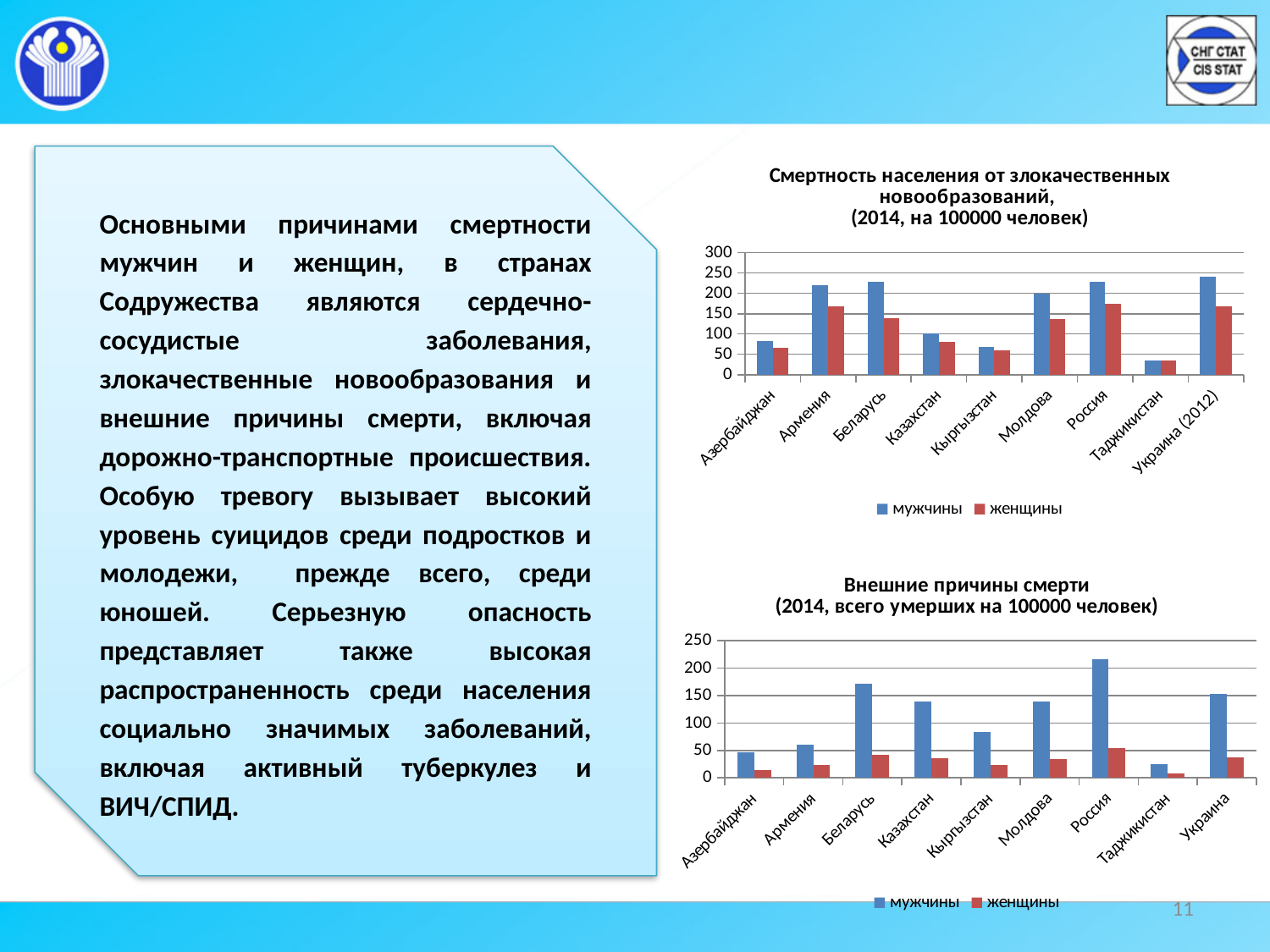
In the top chart (Смертность населения от злокачественных новообразований), is the value for женщины in Казахстан greater or less than 100? less What type of chart is the bottom chart (Внешние причины смерти)? bar chart In the top chart (Смертность населения от злокачественных новообразований), which country has the highest value for мужчины? Украина (2012) In the bottom chart (Внешние причины смерти), which country has the highest value for мужчины? Россия In the top chart (Смертность населения от злокачественных новообразований), which country has the lowest value for мужчины? Таджикистан How many countries are shown on the x axis of the top chart (Смертность населения от злокачественных новообразований)? 9 In the bottom chart (Внешние причины смерти), is the value for мужчины in Россия greater or less than 200? greater In the top chart (Смертность населения от злокачественных новообразований), which is larger for Беларусь: мужчины or женщины? мужчины How many series does the legend of the bottom chart (Внешние причины смерти) list? 2 In the bottom chart (Внешние причины смерти), which country has the lowest value for женщины? Таджикистан In the bottom chart (Внешние причины смерти), is the value for мужчины in Азербайджан greater or less than 100? less